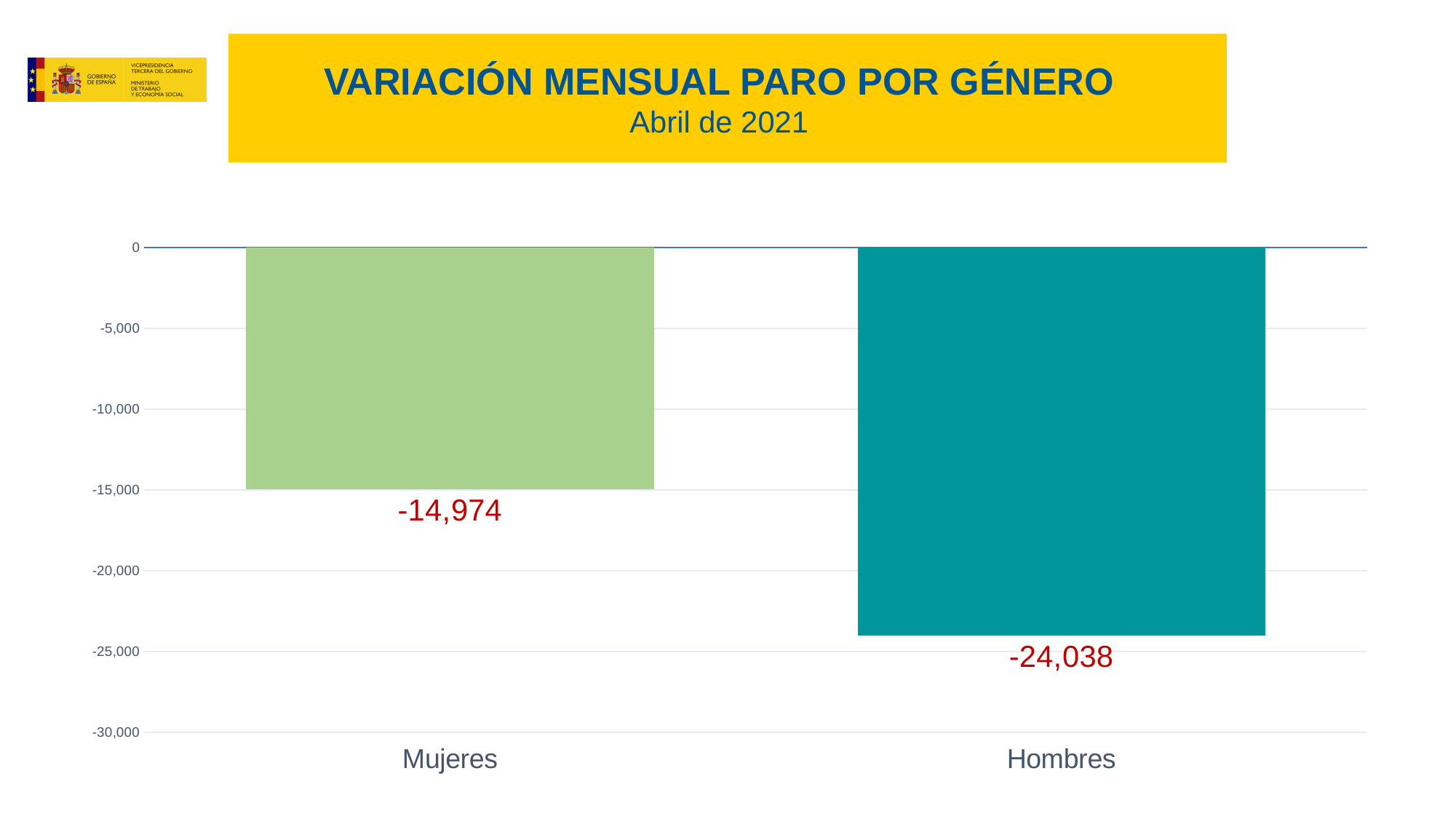
What is the value for Mujeres? -14,974 What month and year does the chart refer to? Abril de 2021 What is the difference between the values for Mujeres and Hombres? 9,064 Is the value for Mujeres greater or less than -15,000? greater What kind of chart is shown on the slide? Bar chart Which bar is larger in magnitude, Mujeres or Hombres? Hombres How many categories are shown on the chart? 2 What is the title of the chart? VARIACIÓN MENSUAL PARO POR GÉNERO Which category has the highest (least negative) value? Mujeres Is the value for Hombres greater or less than -20,000? less What is the value for Hombres? -24,038 Which category has the lowest (most negative) value? Hombres